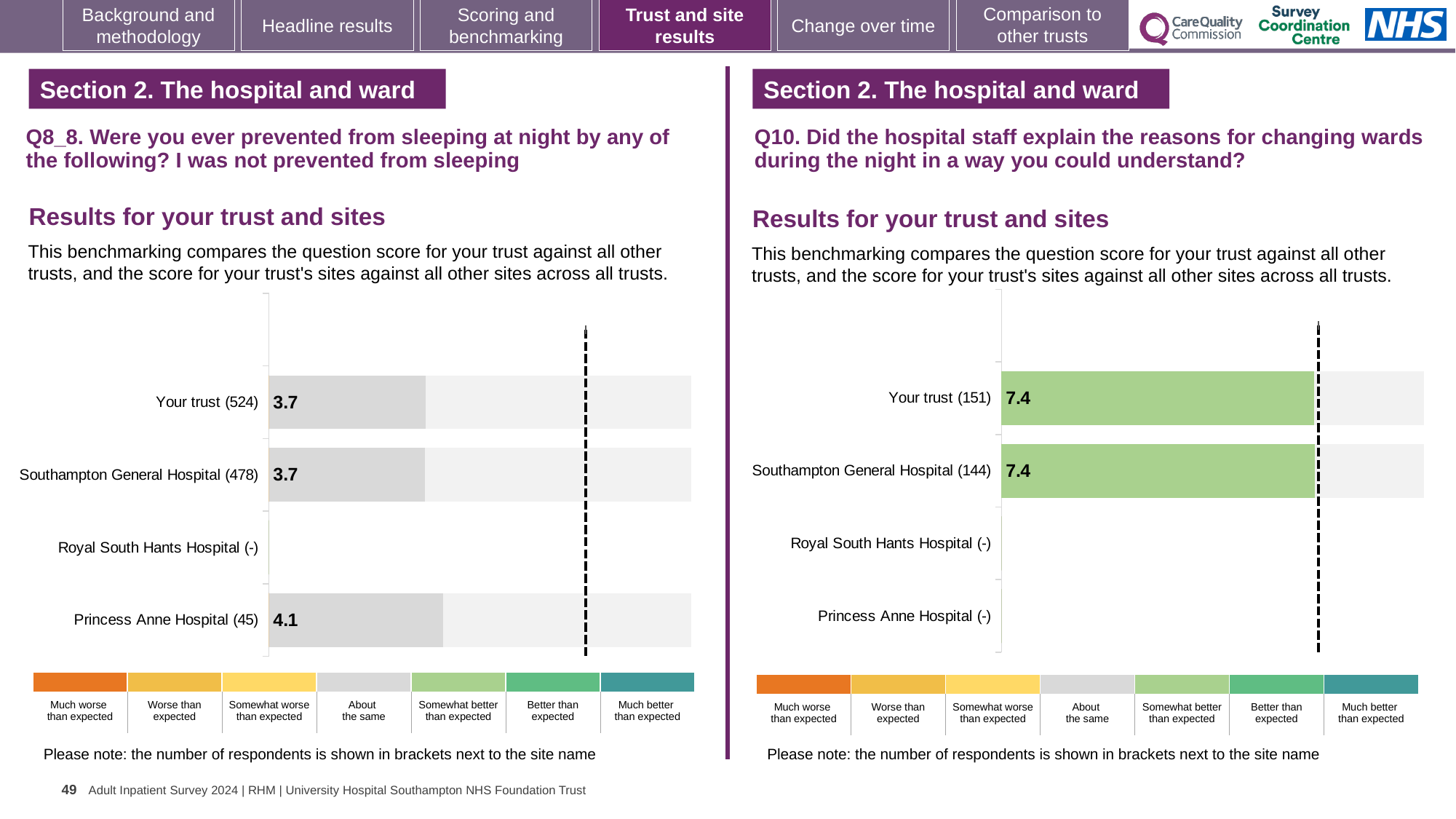
On the left chart (Q8_8), what is the score for Your trust? 3.7 On the right chart (Q10), what is the score for Southampton General Hospital? 7.4 On the left chart (Q8_8), how many respondents are shown for Southampton General Hospital? 478 On the left chart (Q8_8), what is the difference between the scores for Princess Anne Hospital and Your trust? 0.4 On the left chart (Q8_8), what is the score for Southampton General Hospital? 3.7 On the right chart (Q10), what colour category does the bar for Your trust fall into according to the legend? Somewhat better than expected On the right chart (Q10), how many sites have no score shown (marked with a dash)? 2 What type of chart is used on the left (Q8_8)? Bar chart On the right chart (Q10), how many respondents are shown for Your trust? 151 On the left chart (Q8_8), which site has the highest score? Princess Anne Hospital On the left chart (Q8_8), what is the score for Princess Anne Hospital? 4.1 On the right chart (Q10), what is the score for Your trust? 7.4